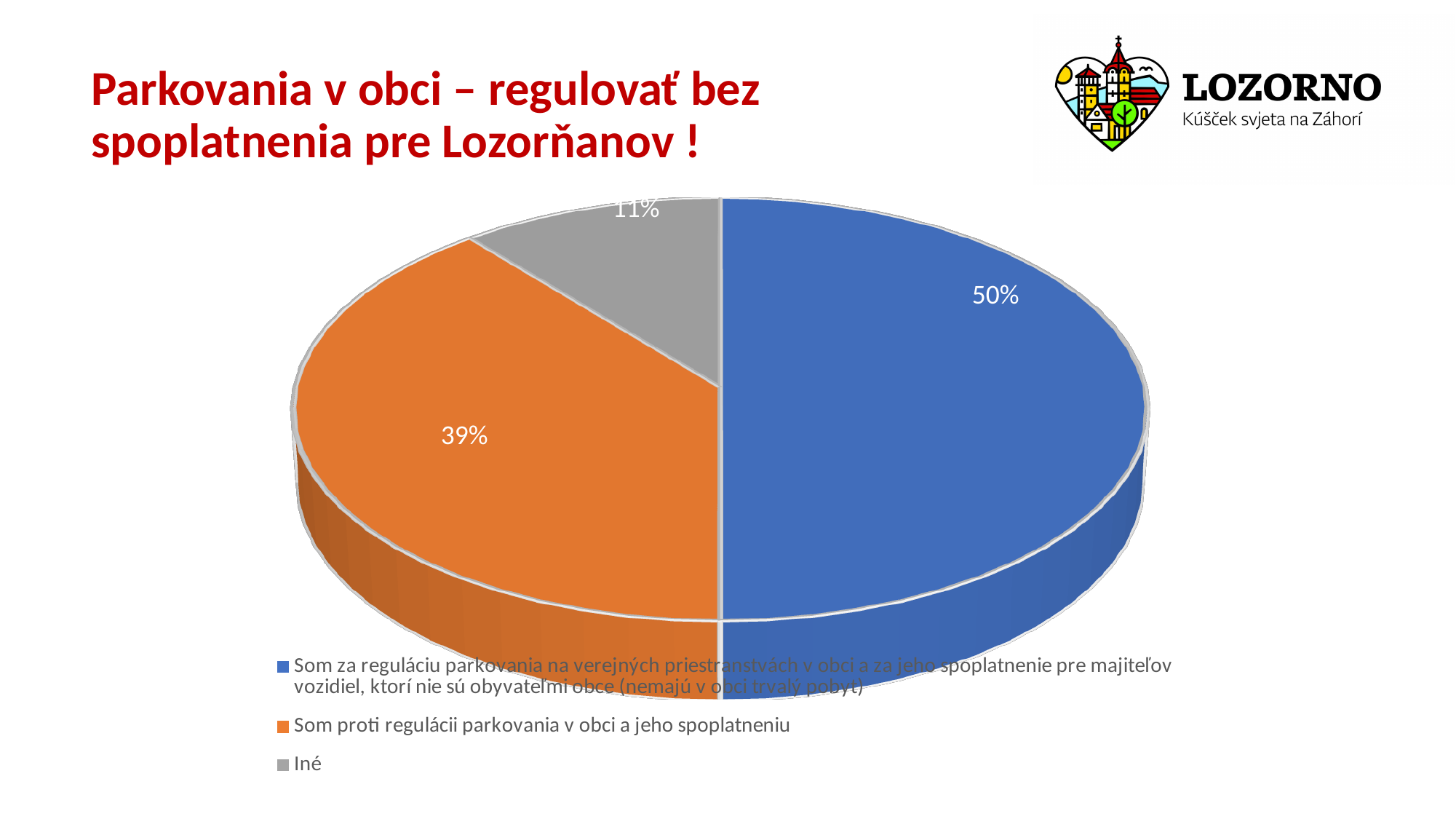
What is the difference in percentage points between the orange slice (39%) and the grey slice (11%)? 28 What share of the pie is labelled 'Som proti regulácii parkovania v obci a jeho spoplatneniu'? 39% What kind of chart is shown on the slide? pie chart What share of the pie is the blue slice (for regulation with fees for non-residents)? 50% Which category has the largest slice of the pie? Som za reguláciu parkovania na verejných priestranstvách v obci a za jeho spoplatnenie pre majiteľov vozidiel, ktorí nie sú obyvateľmi obce (nemajú v obci trvalý pobyt) Which is larger: the slice for 'Som proti regulácii parkovania v obci a jeho spoplatneniu' or the slice for 'Iné'? Som proti regulácii parkovania v obci a jeho spoplatneniu What share of the pie is labelled 'Iné'? 11% Which category has the smallest slice of the pie? Iné What colour is the slice for 'Iné'? grey What is the title of the slide containing the pie chart? Parkovania v obci – regulovať bez spoplatnenia pre Lozorňanov ! How many slices does the pie chart have? 3 What is the difference in percentage points between the blue slice (50%) and the orange slice (39%)? 11